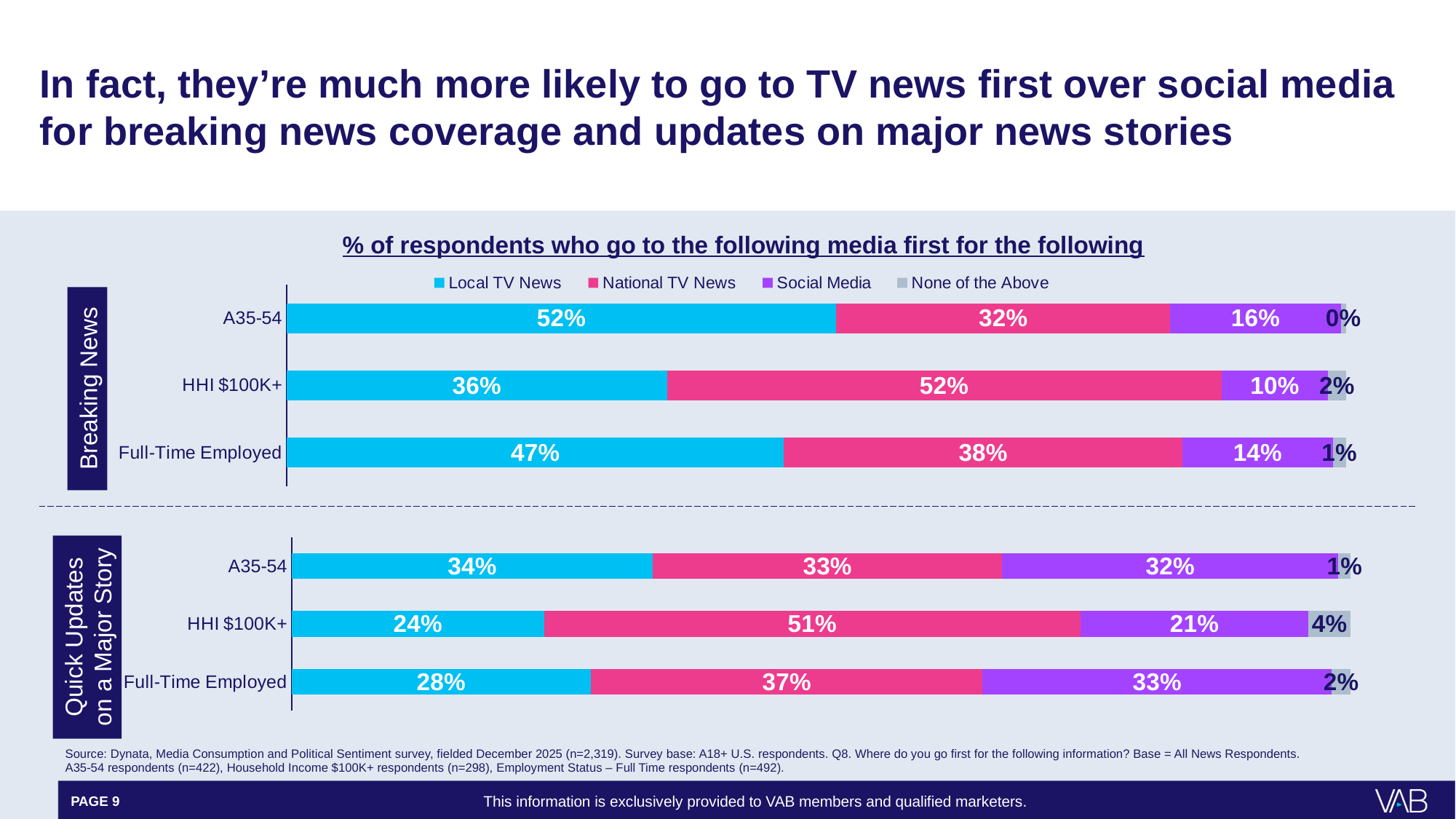
In the Breaking News chart, what is the difference between the Local TV News and Social Media values for Full-Time Employed respondents? 33 percentage points In the Breaking News chart, which group has the highest Local TV News value? A35-54 In the Breaking News chart, what percentage of A35-54 respondents go to Local TV News first? 52% In the Quick Updates on a Major Story chart, what percentage of Full-Time Employed respondents go to Social Media first? 33% In the Quick Updates on a Major Story chart, is the National TV News value for HHI $100K+ larger or smaller than the Social Media value for the same group? larger Which colour represents Social Media in the legend? Purple What type of chart is used for the Quick Updates on a Major Story section? Stacked bar chart In the Breaking News chart, what percentage of HHI $100K+ respondents go to National TV News first? 52% In the Quick Updates on a Major Story chart, which group has the lowest Local TV News value? HHI $100K+ How many series does the legend list for the charts on this slide? 4 How many respondent groups are shown in the Breaking News chart? 3 In the Quick Updates on a Major Story chart, what percentage of HHI $100K+ respondents chose None of the Above? 4%